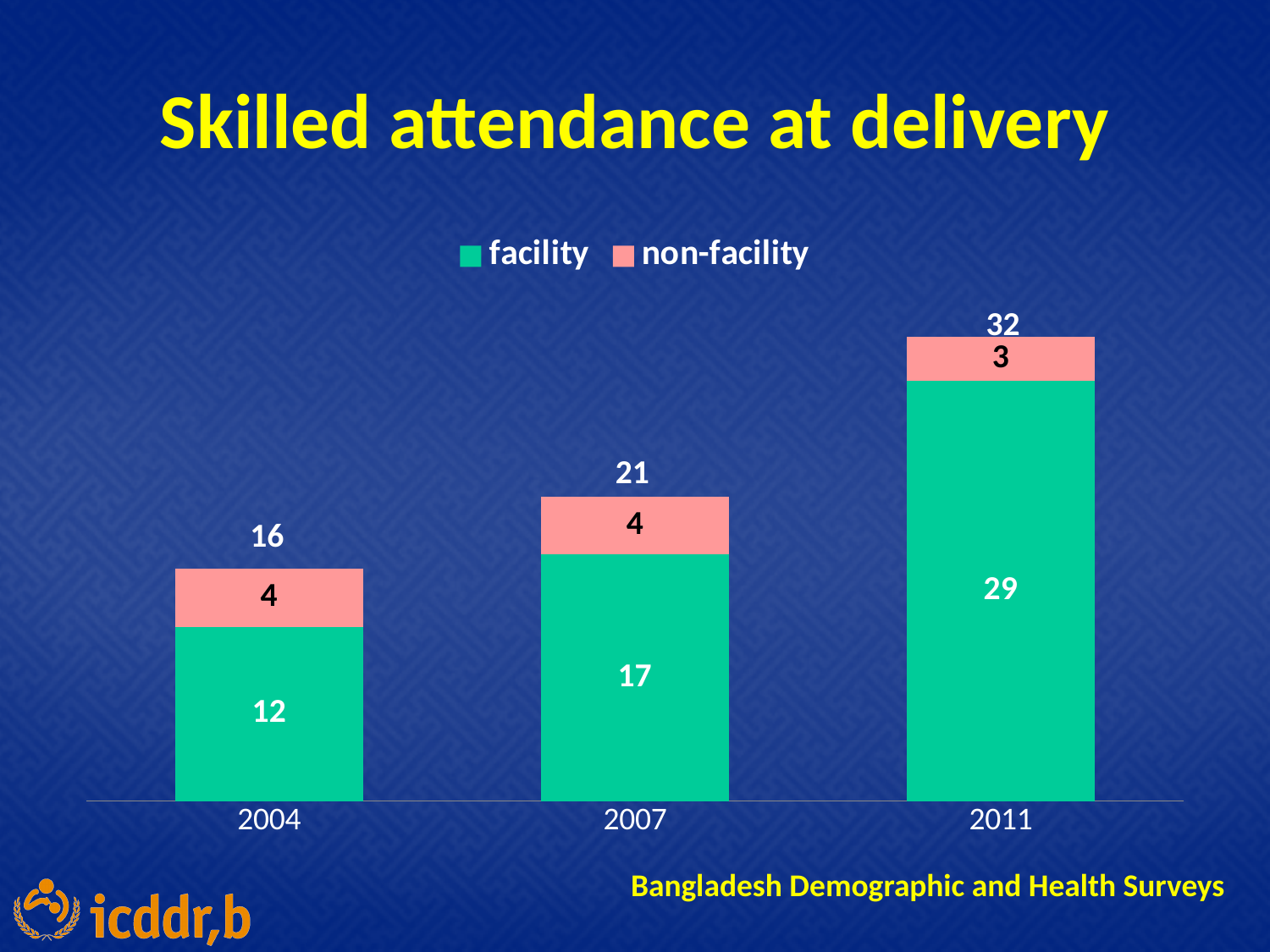
What kind of chart is shown on the slide? Stacked bar chart What is the total of the stacked bar for 2011? 32 What is the difference between the facility values for 2011 and 2007? 12 Which year has the highest facility value? 2011 How many series does the legend list? 2 What is the facility value for 2011? 29 What is the total of the stacked bar for 2007? 21 Which year has the lowest total? 2004 How many years are shown on the x axis? 3 What is the facility value for 2004? 12 Which is larger, the non-facility value for 2004 or for 2011? 2004 What is the non-facility value for 2007? 4